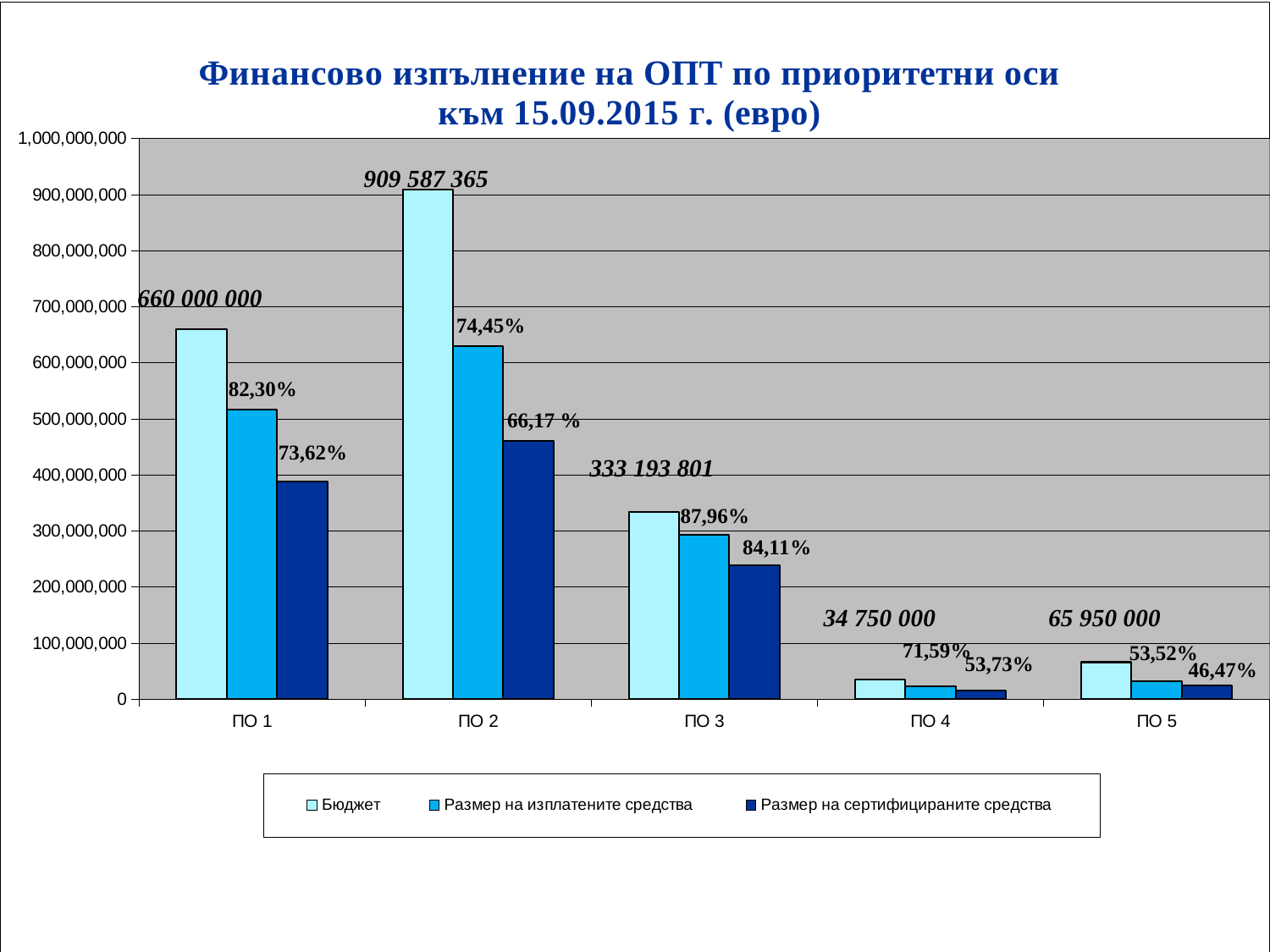
What kind of chart is shown on the slide? bar chart How many priority axes (categories) are shown on the x axis? 5 Is the 'Размер на изплатените средства' bar for ПО 1 greater or less than 500,000,000? greater How many series does the legend list? 3 What is the budget (Бюджет) value labelled for ПО 2? 909 587 365 Which priority axis has the lowest budget (Бюджет)? ПО 4 What is the budget (Бюджет) value labelled for ПО 3? 333 193 801 What percentage is labelled on the 'Размер на сертифицираните средства' bar for ПО 5? 46,47% Which is larger: the budget for ПО 1 or the budget for ПО 3? ПО 1 What is the budget (Бюджет) value labelled for ПО 4? 34 750 000 What percentage is labelled on the 'Размер на изплатените средства' bar for ПО 3? 87,96% Which priority axis has the highest budget (Бюджет)? ПО 2